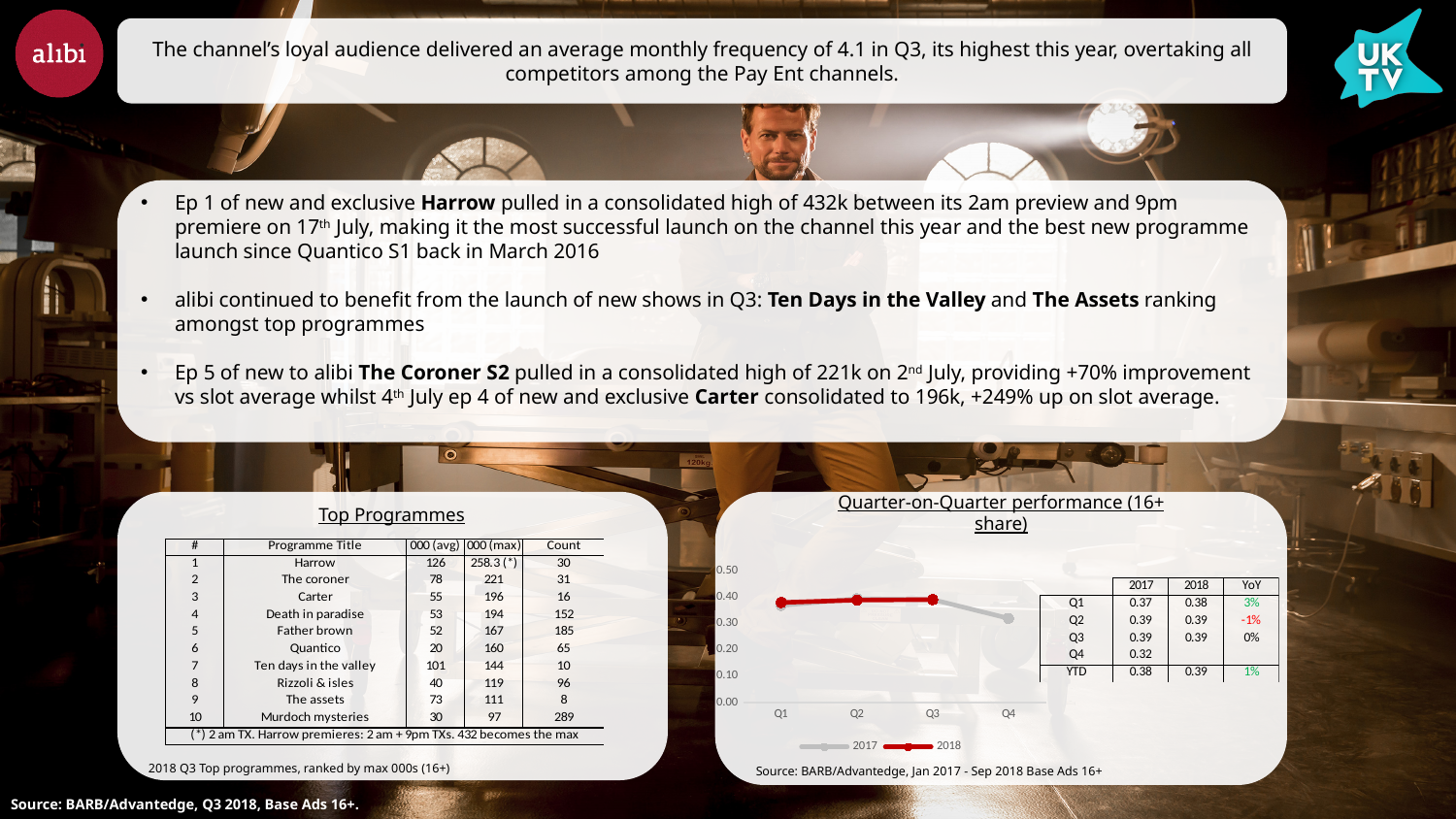
What kind of chart is the Quarter-on-Quarter performance (16+ share) chart? line chart In the Quarter-on-Quarter performance chart, what colour is the 2018 line? red In the Quarter-on-Quarter performance chart, what is the 2018 value for Q1? 0.38 In the Quarter-on-Quarter performance chart, which is larger for 2017: the Q1 value or the Q4 value? Q1 In the Quarter-on-Quarter performance chart, what is the 2017 value for Q4? 0.32 In the Quarter-on-Quarter performance chart, is the 2017 value for Q4 greater or less than 0.40? less In the Quarter-on-Quarter performance chart, which quarter has the lowest 2017 value? Q4 In the Quarter-on-Quarter performance chart, is the 2018 value for Q1 greater or less than 0.30? greater How many series does the legend of the Quarter-on-Quarter performance chart list? 2 In the Quarter-on-Quarter performance chart, does the 2017 line rise or fall from Q3 to Q4? fall In the Quarter-on-Quarter performance chart, what is the YoY change shown for Q2? -1% How many quarters are shown on the x axis of the Quarter-on-Quarter performance chart? 4